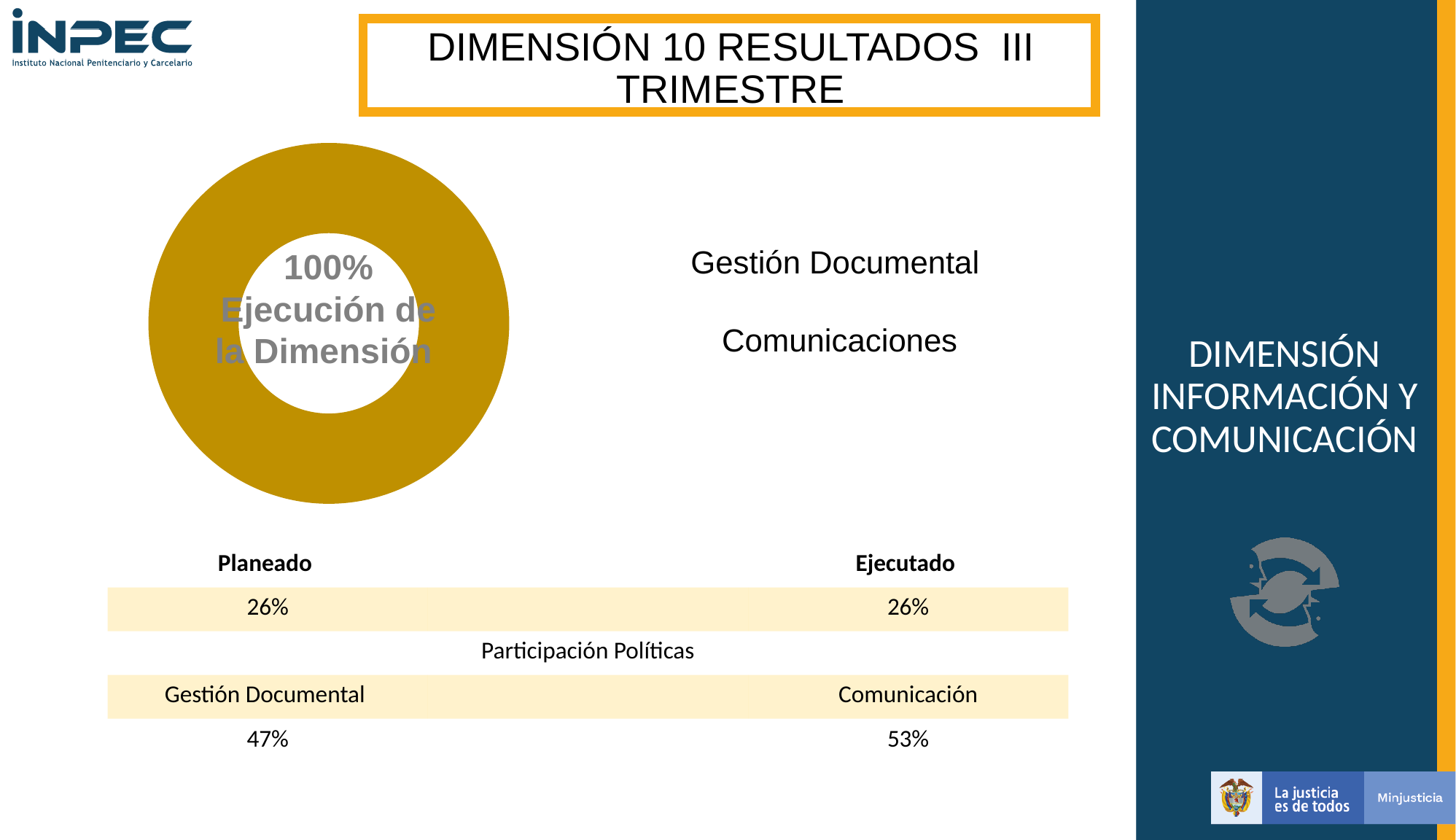
In the table below the donut chart, which is larger, Gestión Documental or Comunicación? Comunicación What does the text inside the donut chart say the 100% represents? Ejecución de la Dimensión In the table below the donut chart, what percentage is shown for Comunicación? 53% What kind of chart is shown on the left of the slide? Donut chart What colour is the ring of the donut chart? Gold In the table below the donut chart, what is the difference between the Comunicación and Gestión Documental percentages? 6% In the table below the donut chart, what percentage is shown for Gestión Documental? 47% In the table below the donut chart, what is the Planeado value? 26% What percentage is shown in the centre of the donut chart? 100% How many slices does the donut chart have? 1 Is the value shown in the donut chart greater or less than 50%? greater In the table below the donut chart, what is the Ejecutado value? 26%